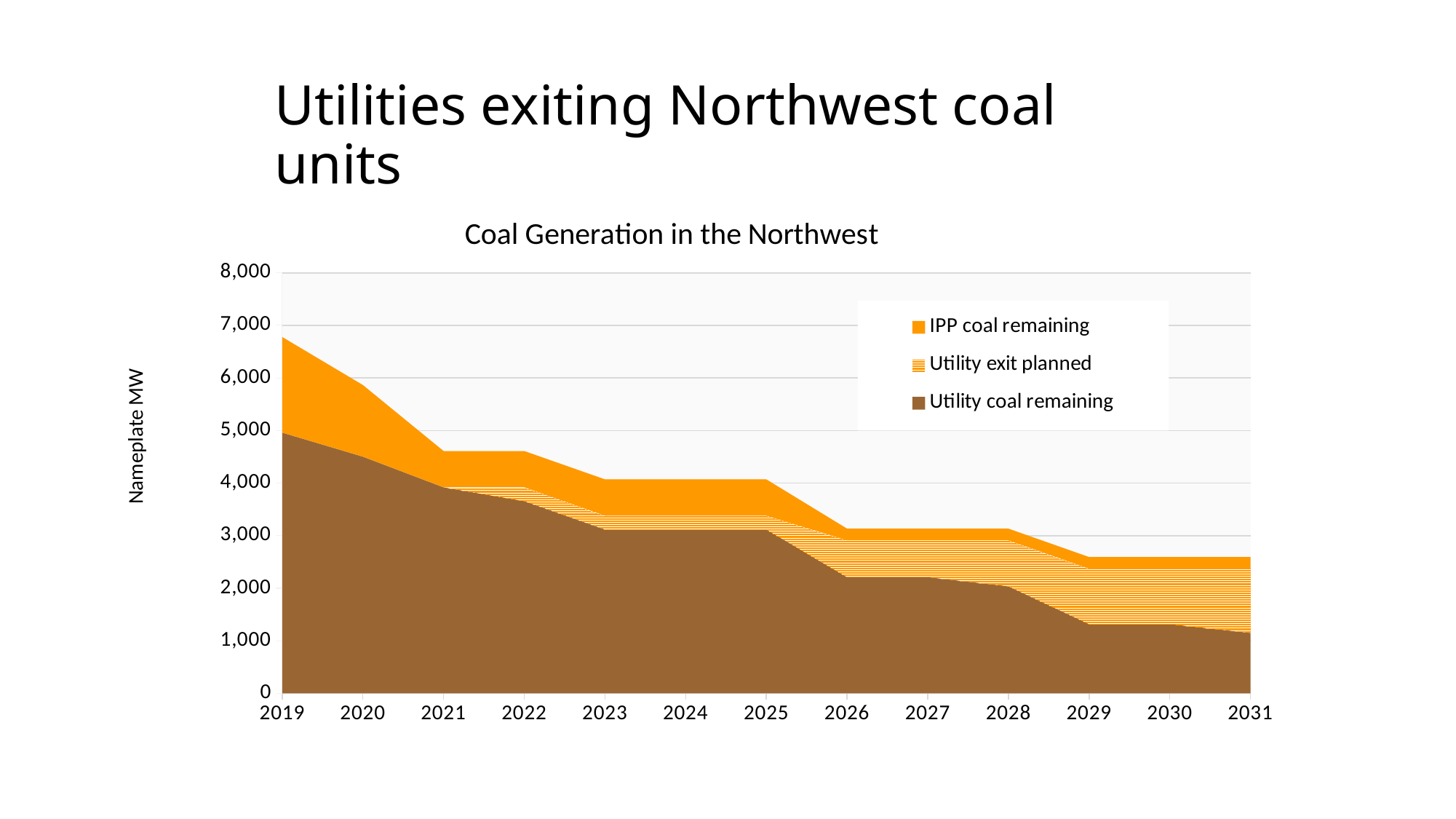
Is the value for Utility coal remaining in 2029 greater or less than 2,000? less Does the total coal generation rise or fall from 2019 to 2031? Fall What is the label on the vertical axis? Nameplate MW Is the total coal generation in 2019 greater or less than 6,000? greater How many years are shown along the x axis? 13 Is the total coal generation in 2031 greater or less than 3,000? less In which year is the total coal generation highest? 2019 What is the title of the chart? Coal Generation in the Northwest How many series does the legend list? 3 Which is larger, the total coal generation in 2019 or in 2031? 2019 What kind of chart is shown on the slide? Stacked area chart